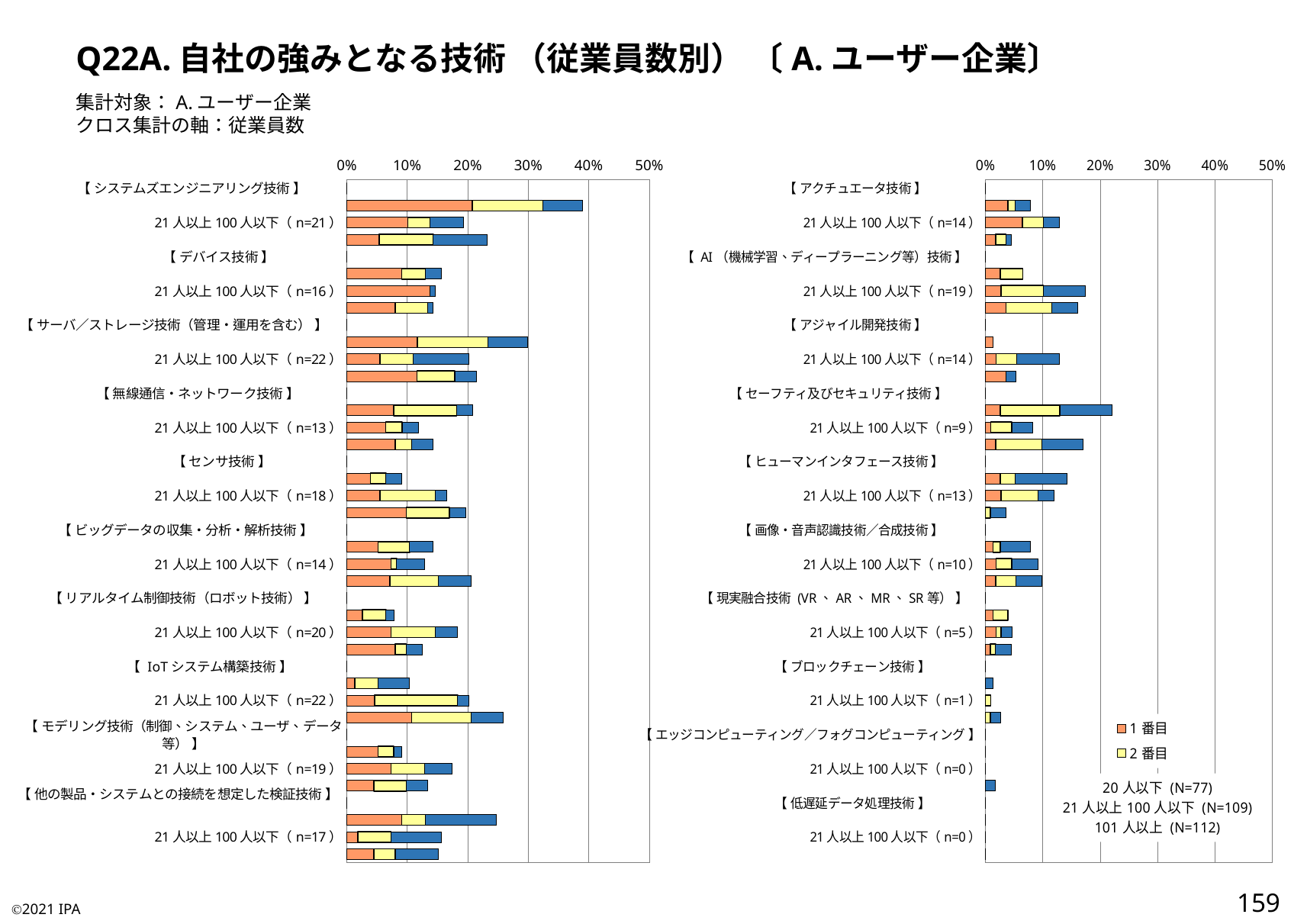
What is the maximum value shown on the horizontal axis of the charts? 50% In the left chart, which technology group has the longest bar overall? 【システムズエンジニアリング技術】 In the right chart, is the value of the top bar for 【セーフティ及びセキュリティ技術】 (20人以下) greater or less than 15%? greater In the right chart, which top bar is longer: 【セーフティ及びセキュリティ技術】 or 【アクチュエータ技術】? 【セーフティ及びセキュリティ技術】 What is the title of the slide? Q22A. 自社の強みとなる技術（従業員数別）〔A. ユーザー企業〕 In the right chart, is the value of the top bar for 【アジャイル開発技術】 (20人以下) greater or less than 10%? less What kind of chart is used on the left side of the slide? bar chart In the right chart, is the bar for 【ブロックチェーン技術】 21人以上100人以下 (n=1) greater or less than 5%? less In the right chart, which technology group has the longest bar overall? 【セーフティ及びセキュリティ技術】 In the left chart, which top bar is longer: 【システムズエンジニアリング技術】 or 【デバイス技術】? 【システムズエンジニアリング技術】 How many technology groups are listed in the left chart? 10